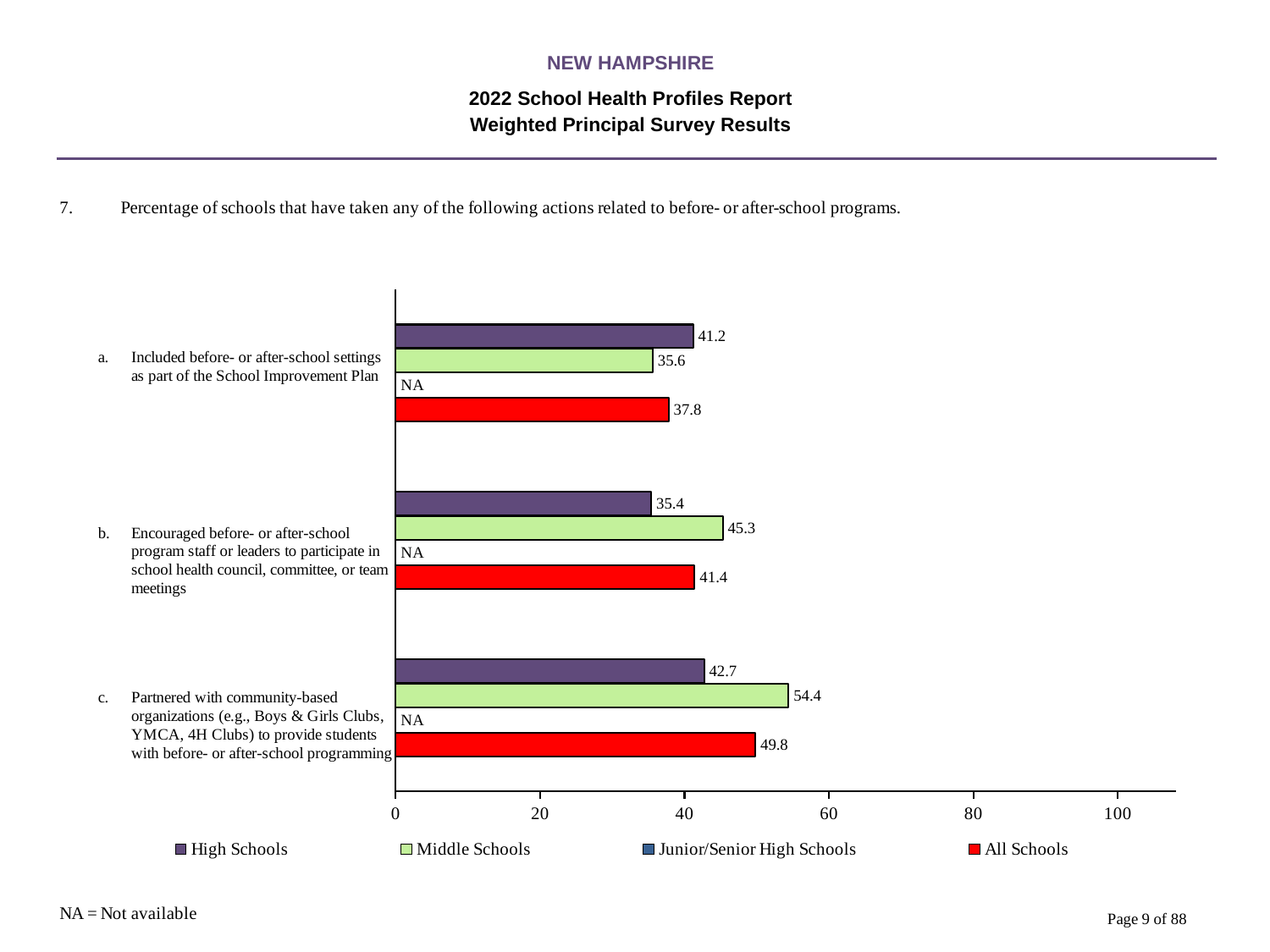
What colour represents All Schools in the legend? Red What is shown for Junior/Senior High Schools for item a? NA For item a, which is larger: the High Schools value or the Middle Schools value? High Schools What is the value for High Schools for item a, 'Included before- or after-school settings as part of the School Improvement Plan'? 41.2 What is the value for All Schools for item b, 'Encouraged before- or after-school program staff or leaders to participate in school health council, committee, or team meetings'? 41.4 Is the All Schools value for item c greater or less than 40? greater What kind of chart is shown on the slide? Bar chart Which item has the lowest value for High Schools? b. Encouraged before- or after-school program staff or leaders to participate in school health council, committee, or team meetings What is the value for Middle Schools for item c, 'Partnered with community-based organizations to provide students with before- or after-school programming'? 54.4 Which item has the highest value for Middle Schools? c. Partnered with community-based organizations What is the difference between the Middle Schools and High Schools values for item c? 11.7 How many series does the legend list? 4